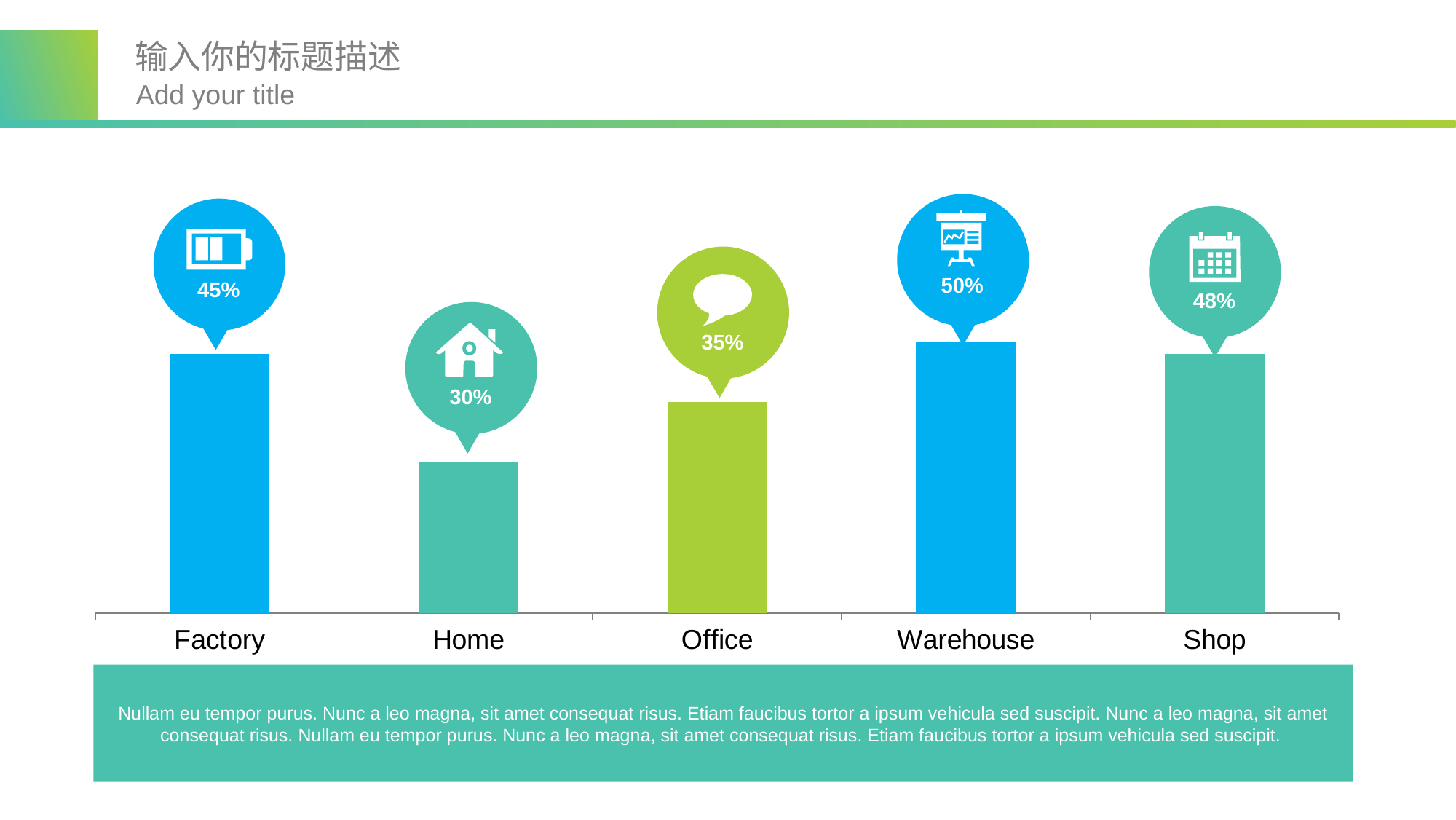
What is the difference between the values for Warehouse and Home? 20% What is the value for Shop? 48% What is the value for Office? 35% How many categories are shown in the chart? 5 Which category has the highest value? Warehouse What is the value for Home? 30% Which is larger, the value for Factory or the value for Office? Factory Which category has the lowest value? Home What is the value for Factory? 45% What kind of chart is shown on the slide? Bar chart What colour is the bar for Office? Green What is the value for Warehouse? 50%